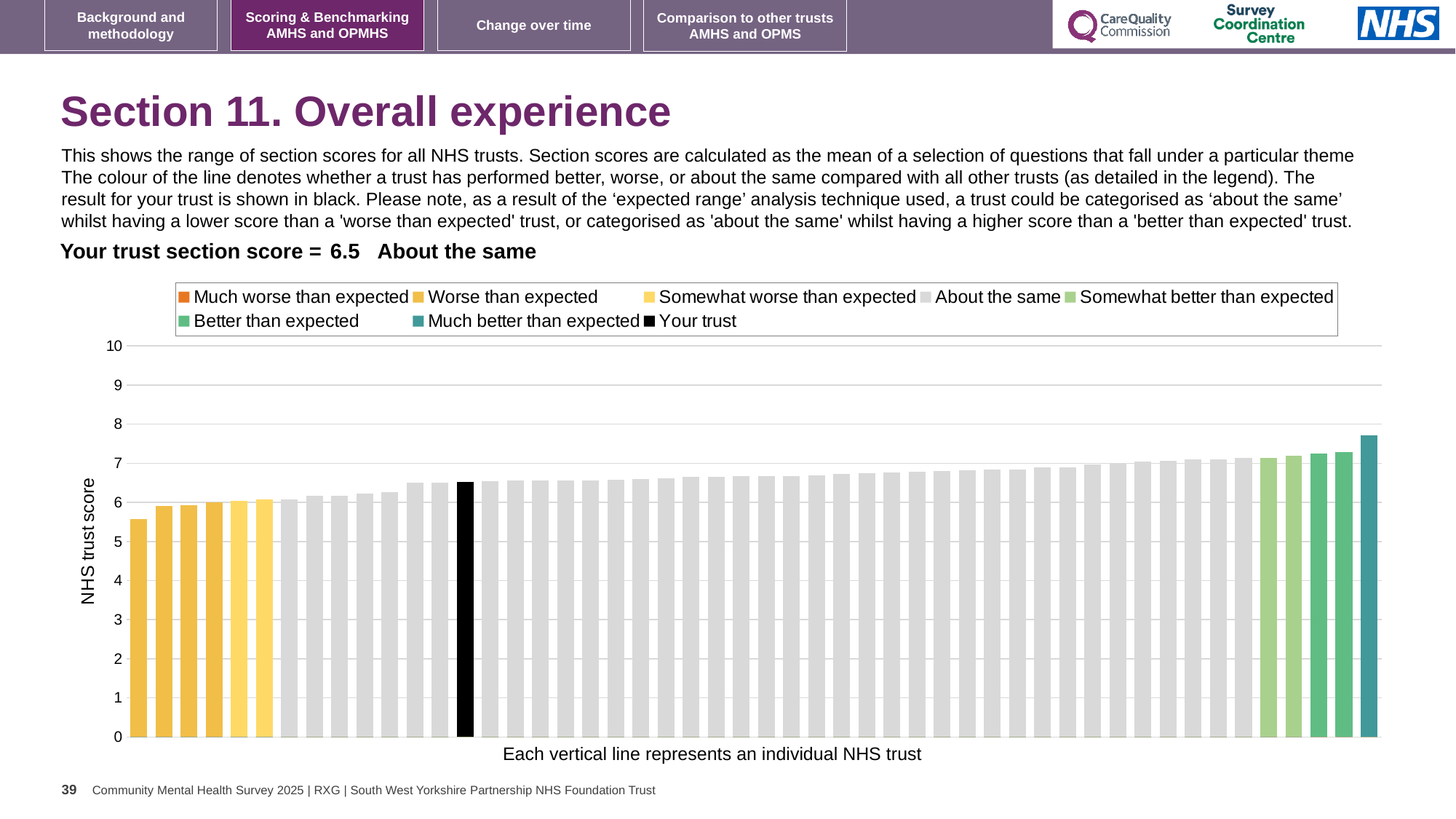
Is the value of the rightmost bar greater or less than 7? greater What is the section score for your trust shown on the slide? 6.5 Is the value of the tallest bar greater or less than 8? less Is the value for your trust (the black bar) greater or less than 6? greater How many entries does the chart legend list? 8 What kind of chart is shown on the slide? bar chart What is the label on the vertical axis of the chart? NHS trust score Which legend category does the tallest bar belong to? Much better than expected Which category is your trust placed in for this section? About the same Do the bar values rise or fall from left to right along the x axis? rise Which is taller: the black bar for your trust or the rightmost bar? the rightmost bar